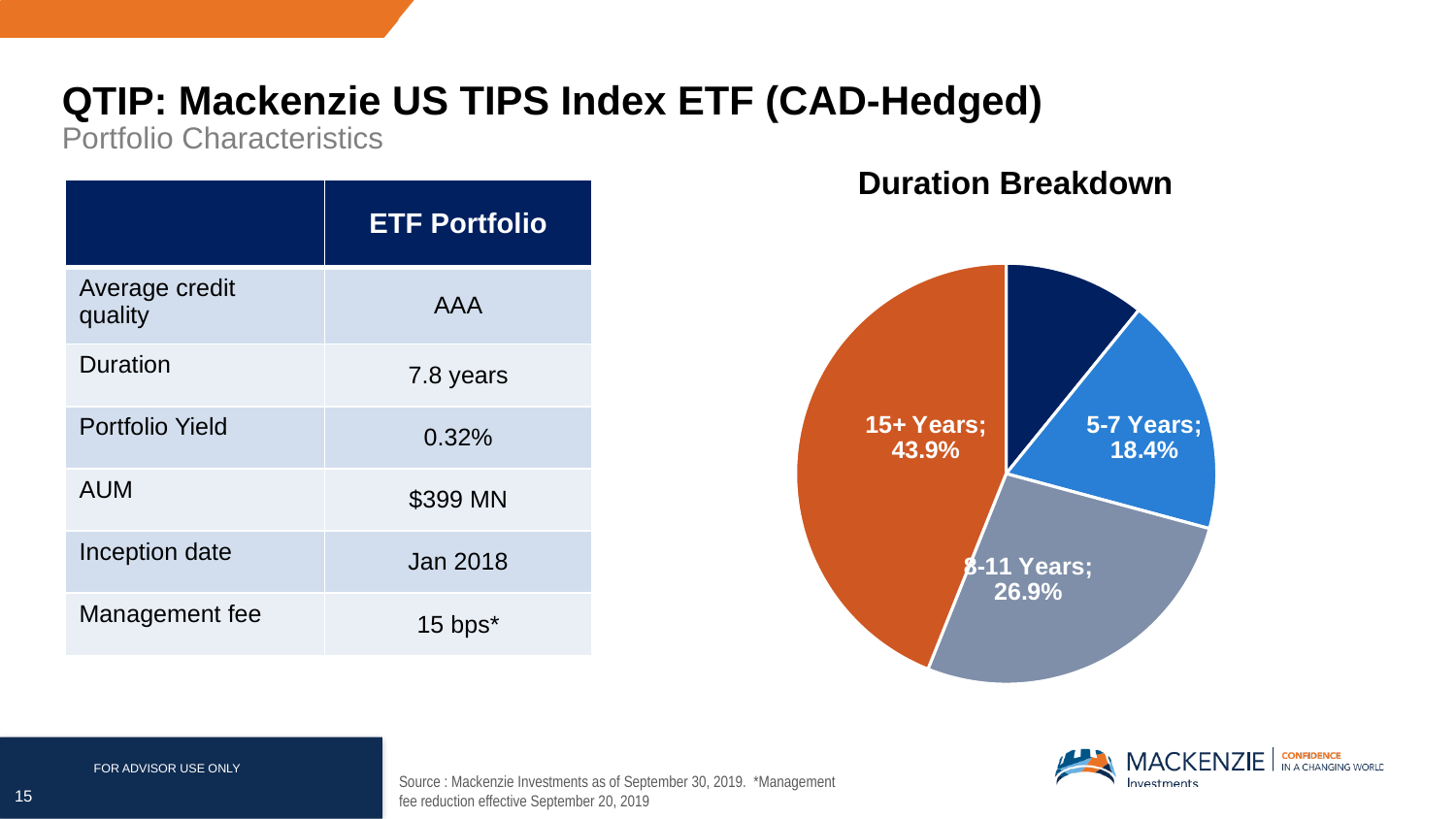
In the Duration Breakdown pie chart, what is the difference in percentage points between the 15+ Years share and the 8-11 Years share? 17.0 Which slice of the Duration Breakdown pie chart has the largest share? 15+ Years What colour is the 15+ Years slice in the Duration Breakdown pie chart? orange In the Duration Breakdown pie chart, what share is labeled for 5-7 Years? 18.4% In the Duration Breakdown pie chart, which is larger: the 8-11 Years slice or the 5-7 Years slice? 8-11 Years How many slices does the Duration Breakdown pie chart have? 4 Of the slices labeled with a percentage in the Duration Breakdown pie chart, which has the smallest share? 5-7 Years What is the title of the chart on the slide? Duration Breakdown What kind of chart is shown under the title "Duration Breakdown"? pie chart In the Duration Breakdown pie chart, what share is labeled for 15+ Years? 43.9% In the Duration Breakdown pie chart, what is the difference in percentage points between the 8-11 Years share and the 5-7 Years share? 8.5 In the Duration Breakdown pie chart, what share is labeled for 8-11 Years? 26.9%